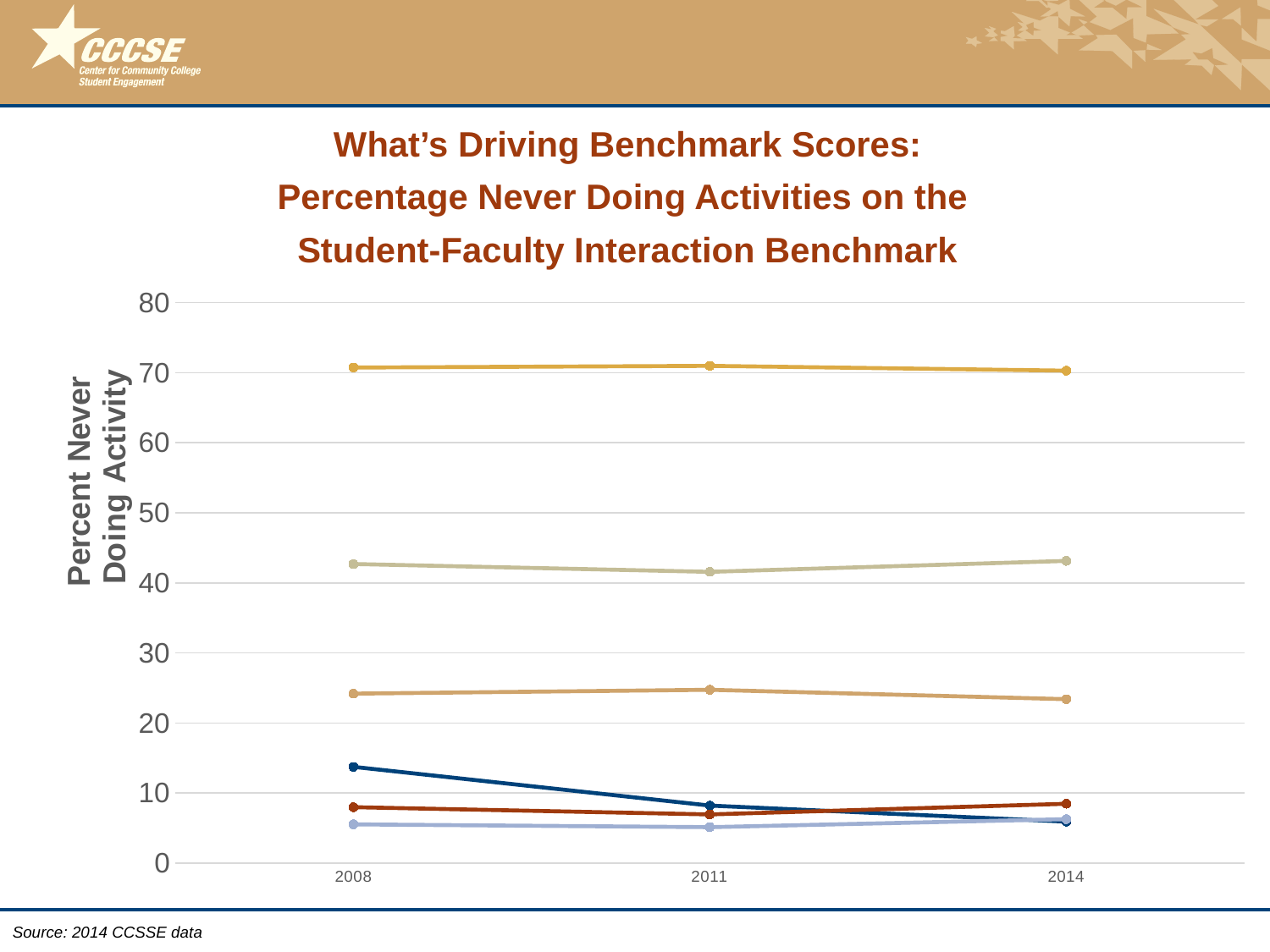
What is the label on the y axis of the chart? Percent Never Doing Activity How many years are shown along the x axis of the chart? 3 Is the value of the second-highest line in 2014 greater or less than 50? less How many lines are plotted on the chart? 6 Is the value of the third-highest line in 2011 greater or less than 30? less Does the dark blue line rise or fall from 2008 to 2014? fall Is the value of the dark blue line in 2008 greater or less than 10? greater What kind of chart is shown on the slide? line chart Which years are shown on the x axis of the chart? 2008, 2011, 2014 In 2008, which is larger: the value of the topmost line or the value of the second-highest line? the topmost line